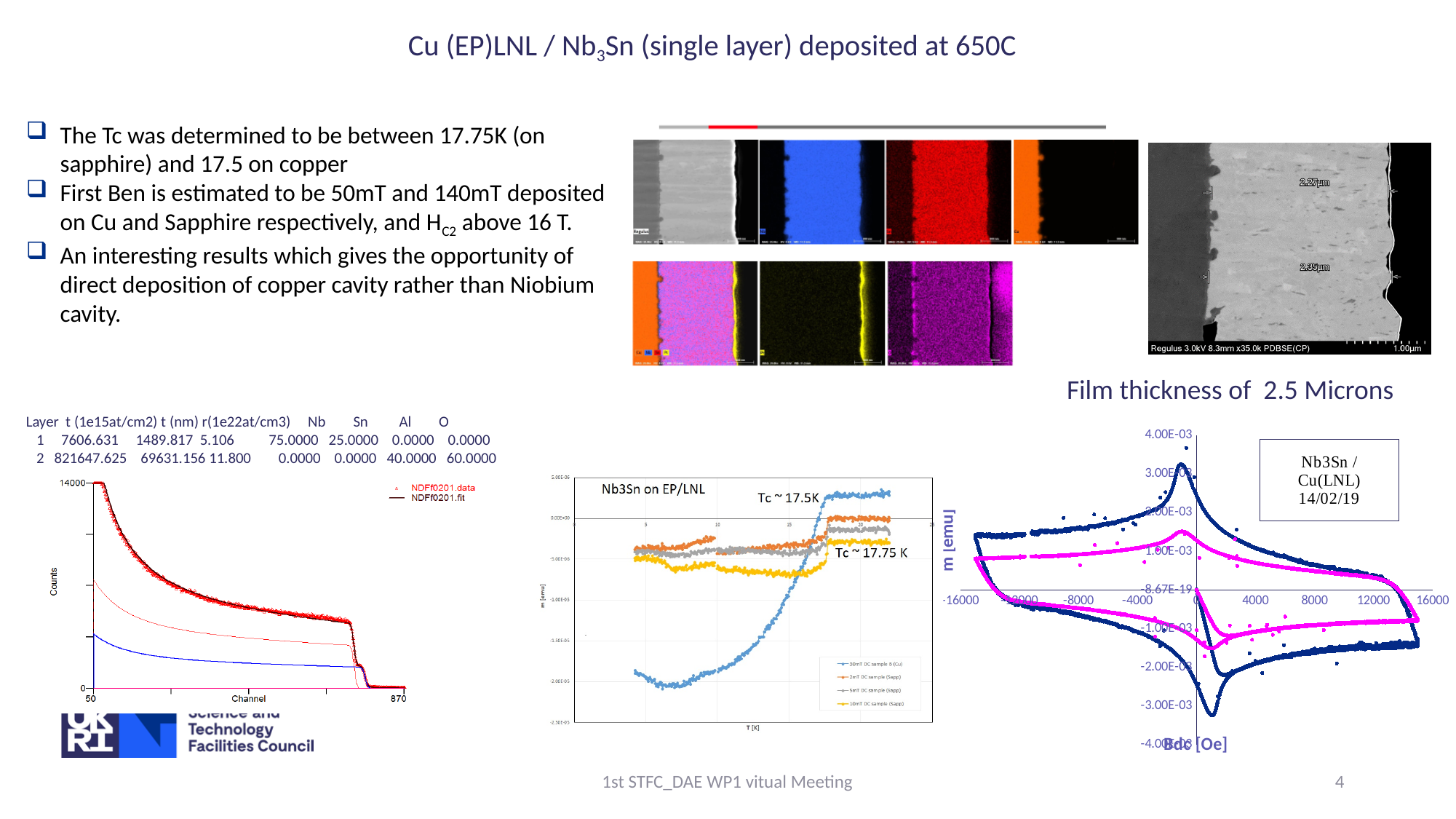
On the middle chart, what Tc value is annotated for the lower curves? Tc ~ 17.75 K How many series does the legend of the middle chart list? 4 On the bottom-left chart, what is the last tick value shown on the Channel axis? 870 On the bottom-left chart, what is the highest value shown on the Counts axis? 14000 On the right-hand hysteresis chart, what is the label of the x axis? Bdc [Oe] On the bottom-left chart, do the counts rise or fall as the channel increases? fall What is the title of the middle chart showing m [emu] against T [K]? Nb3Sn on EP/LNL On the right-hand hysteresis chart, is the peak value of the dark blue loop greater or less than 3.00E-03? greater What kind of chart is the bottom-left chart with Counts on the y axis? line chart On the bottom-left chart, what is the label of the x axis? Channel On the middle chart, what Tc value is annotated for the upper (blue) curve? Tc ~ 17.5K How many series does the legend of the bottom-left chart list? 2